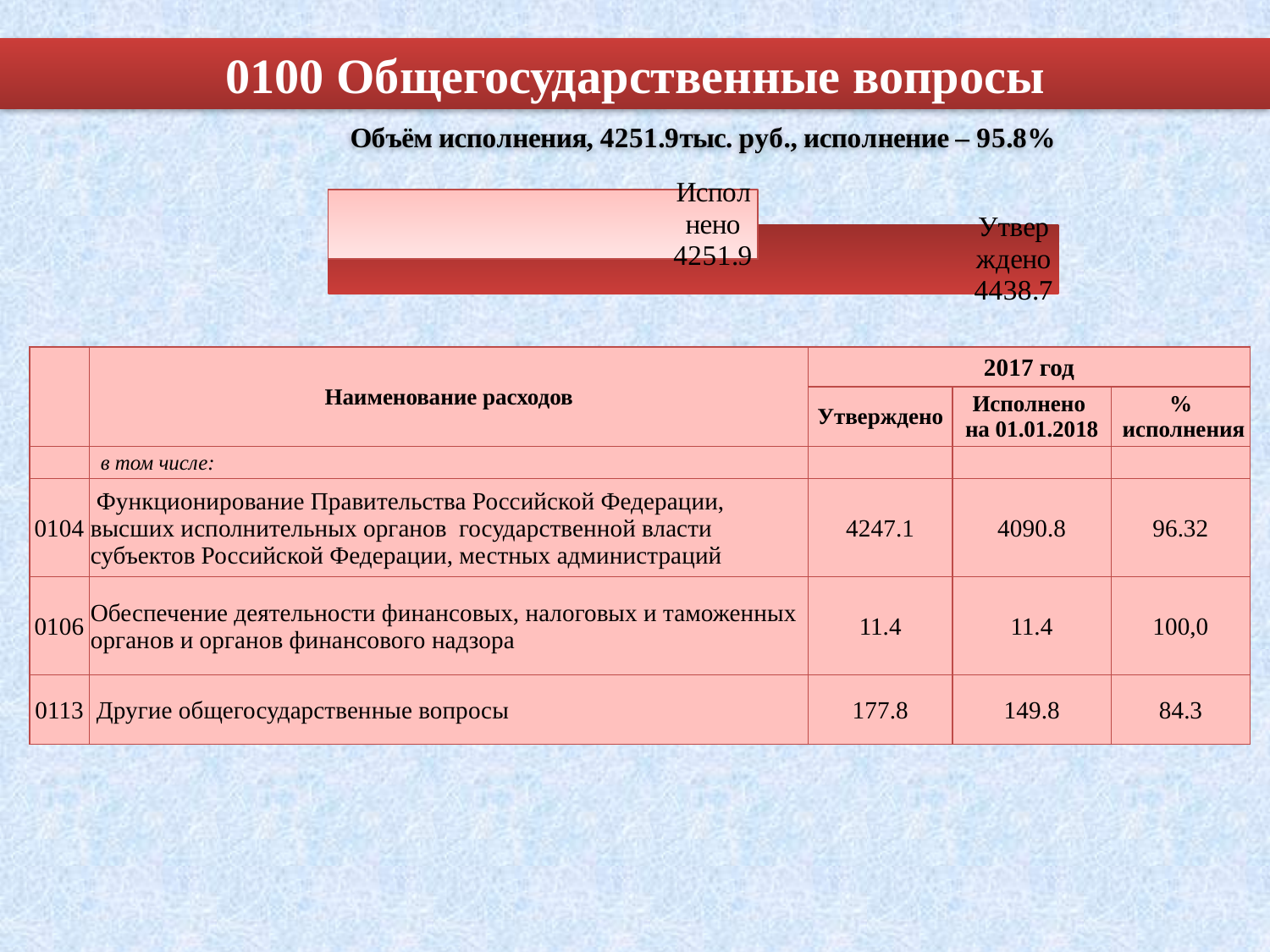
What is the title of the slide containing the chart? 0100 Общегосударственные вопросы What is the value of the bar labelled Утверждено? 4438.7 Which bar has the highest value? Утверждено Which bar has the lowest value? Исполнено What kind of chart is shown on the slide? bar chart What is the value of the bar labelled Исполнено? 4251.9 What is the difference between the Утверждено and Исполнено values? 186.8 What execution percentage is stated in the subtitle above the chart? 95.8% Which bar has the higher value, Исполнено or Утверждено? Утверждено How many bars does the chart show? 2